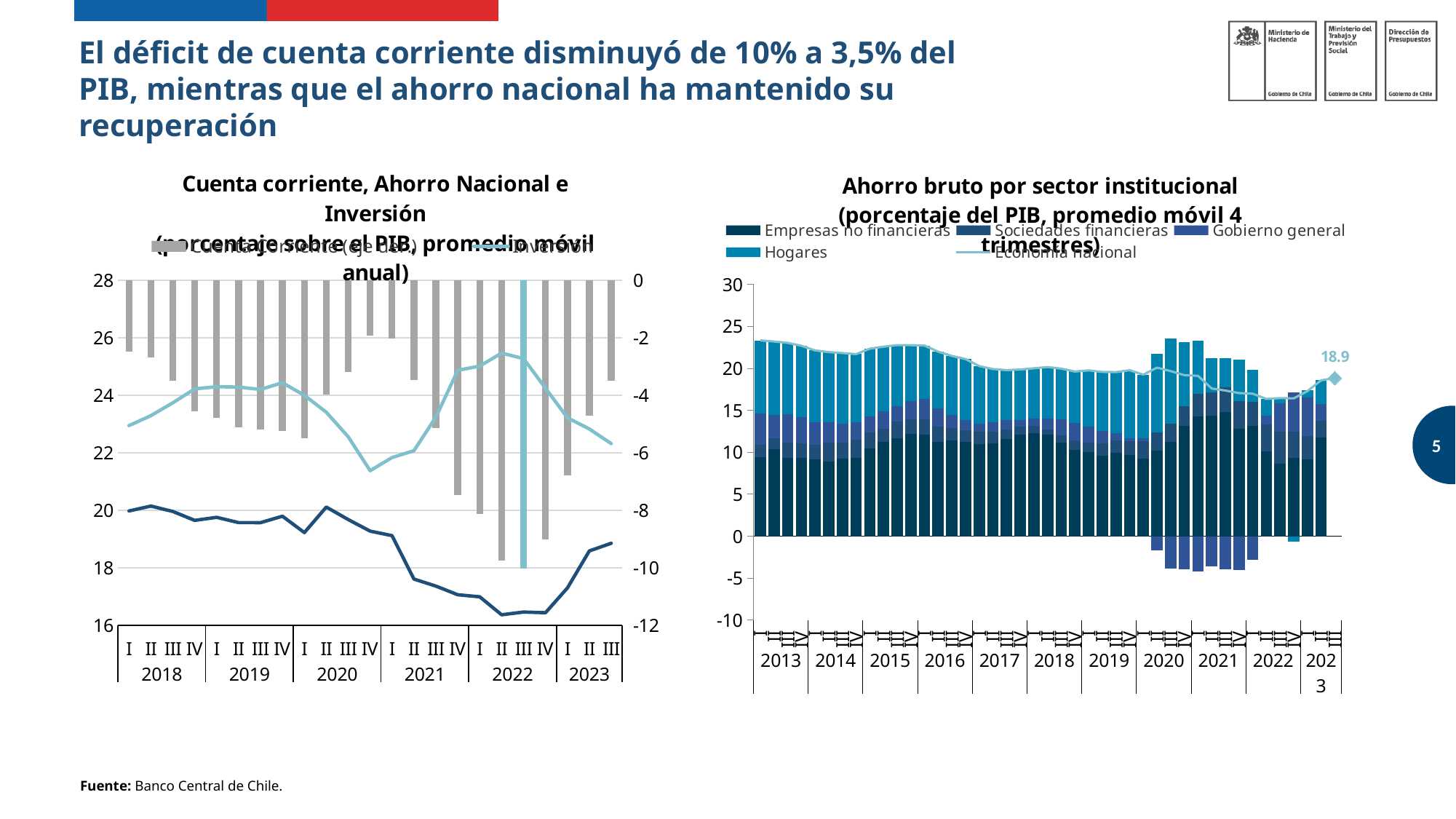
In the 'Ahorro bruto por sector institucional' chart, is the Economía nacional value in 2013 greater or less than 20? greater In the 'Ahorro bruto por sector institucional' chart, is the Gobierno general value in 2021 greater or less than 0? less In the 'Ahorro bruto por sector institucional' chart, which series forms the bottom segment of the stacked bars? Empresas no financieras In the 'Cuenta corriente, Ahorro Nacional e Inversión' chart, does the dark blue Ahorro nacional line rise or fall from 2018 to 2022? fall In the 'Ahorro bruto por sector institucional' chart, does the Economía nacional line rise or fall between 2013 and 2019? fall In the 'Ahorro bruto por sector institucional' chart, what is the labelled value of the Economía nacional line at its last point in 2023? 18.9 How many years are shown on the x axis of the 'Cuenta corriente, Ahorro Nacional e Inversión' chart? 6 In the 'Cuenta corriente, Ahorro Nacional e Inversión' chart, is the Inversión value in 2020 IV greater or less than 22? less How many series does the legend of the 'Ahorro bruto por sector institucional' chart list? 5 How many years are shown on the x axis of the 'Ahorro bruto por sector institucional' chart? 11 In the 'Cuenta corriente, Ahorro Nacional e Inversión' chart, which line is higher in 2018 I, Inversión or the dark blue Ahorro nacional line? Inversión